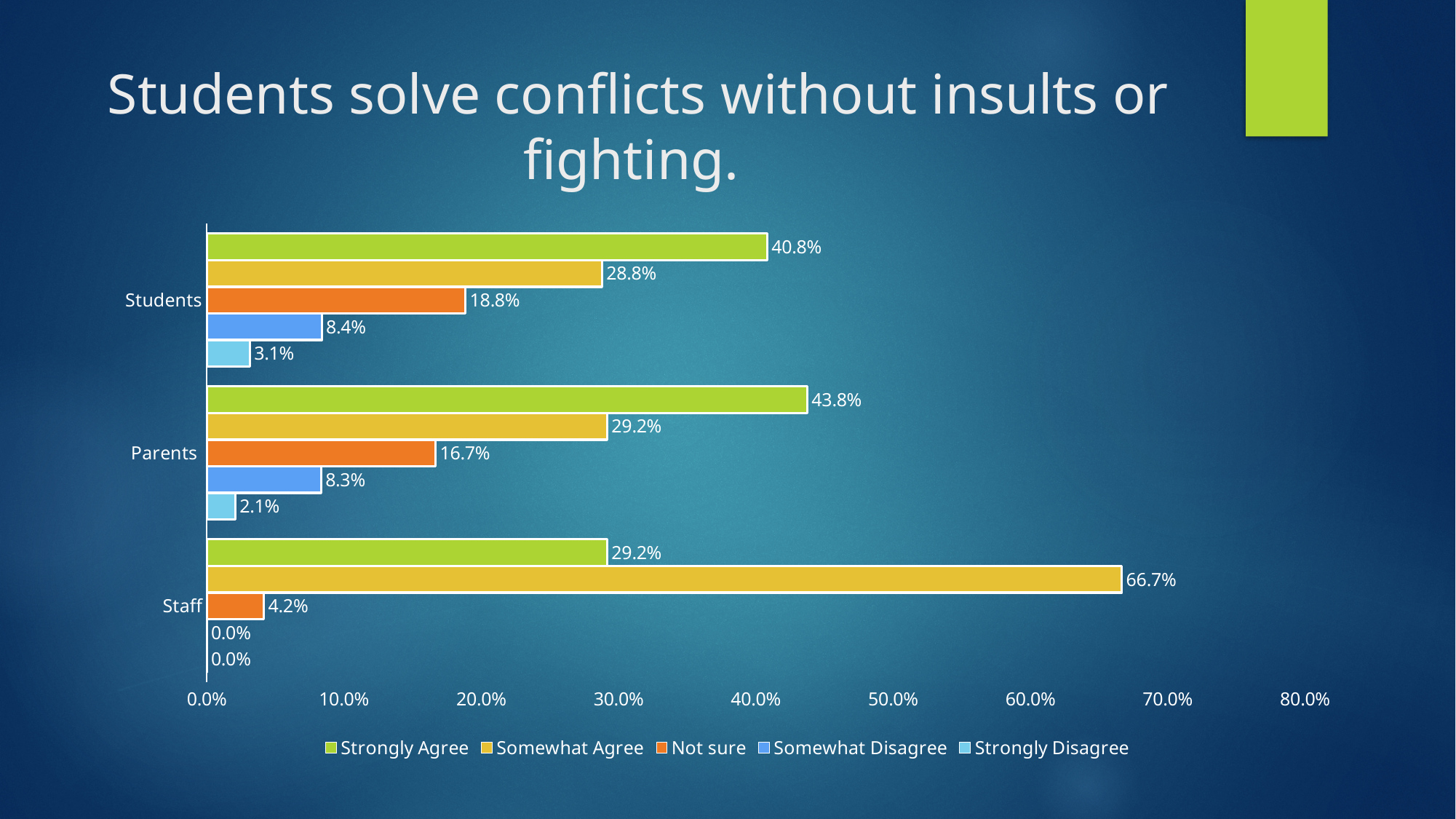
Which group has the highest Strongly Agree percentage? Parents How many respondent groups are shown on the chart? 3 Is the Somewhat Agree value for Staff greater or less than 60.0%? greater What percentage of Staff responded Somewhat Agree? 66.7% Which is larger: the Strongly Disagree percentage for Students or for Parents? Students What percentage of Parents responded Not sure? 16.7% What percentage of Staff responded Strongly Disagree? 0.0% How many series does the legend list? 5 Which group has the lowest Not sure percentage? Staff What is the difference between the Somewhat Agree percentages for Staff and Students? 37.9% What kind of chart is shown on the slide? Bar chart What percentage of Students responded Strongly Agree? 40.8%